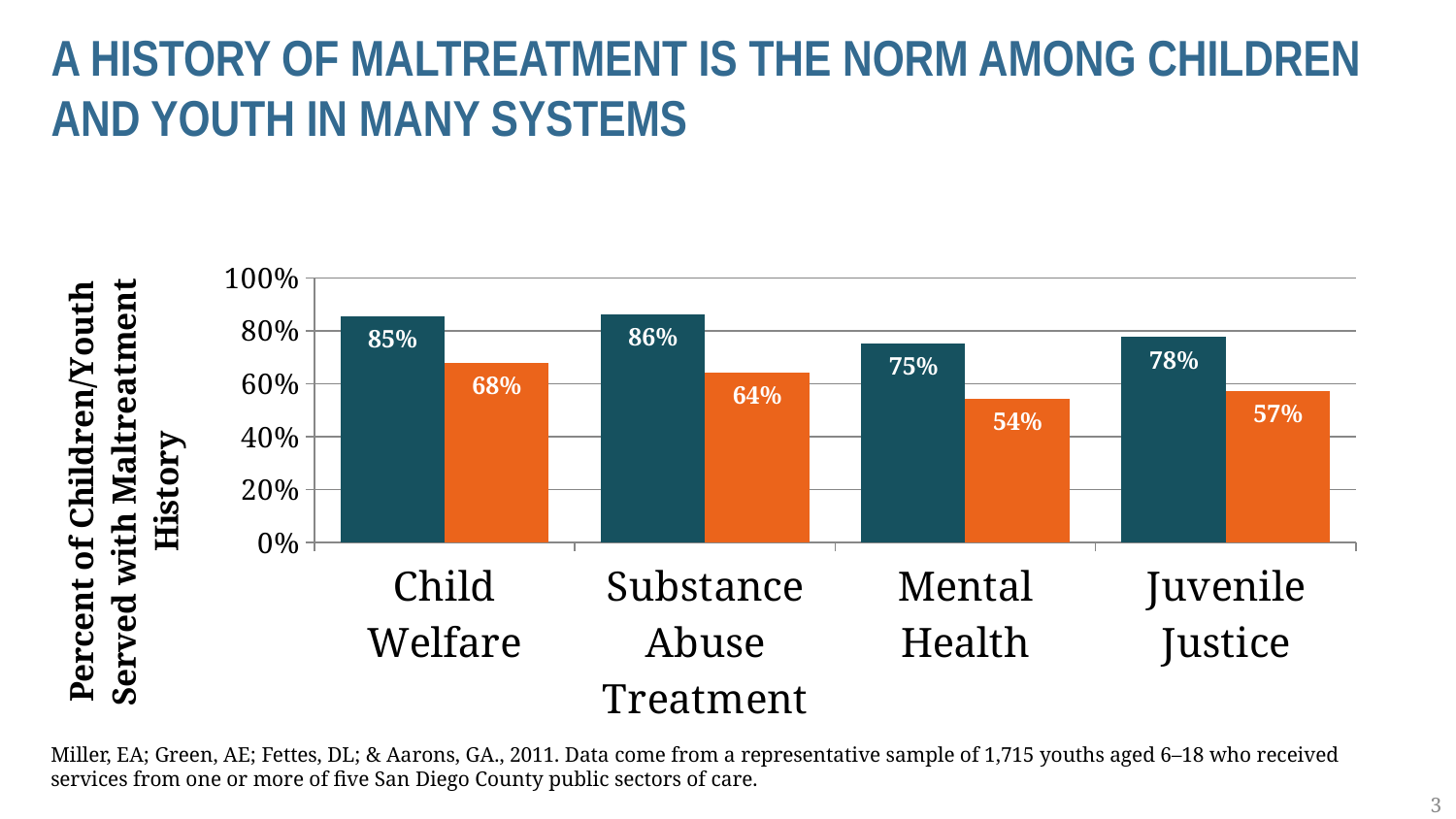
What is the difference between the dark teal and orange bars for Child Welfare? 17 percentage points Which is larger: the orange bar for Child Welfare or the orange bar for Substance Abuse Treatment? Child Welfare What is the value of the orange bar for Juvenile Justice? 57% Is the dark teal bar for Mental Health greater or less than 80%? less Which category has the lowest orange bar? Mental Health How many categories are shown on the x axis? 4 What is the value of the dark teal bar for Child Welfare? 85% What is the value of the dark teal bar for Substance Abuse Treatment? 86% What is the value of the orange bar for Mental Health? 54% Which category has the highest dark teal bar? Substance Abuse Treatment What is the label of the y axis? Percent of Children/Youth Served with Maltreatment History What kind of chart is shown on the slide? Bar chart